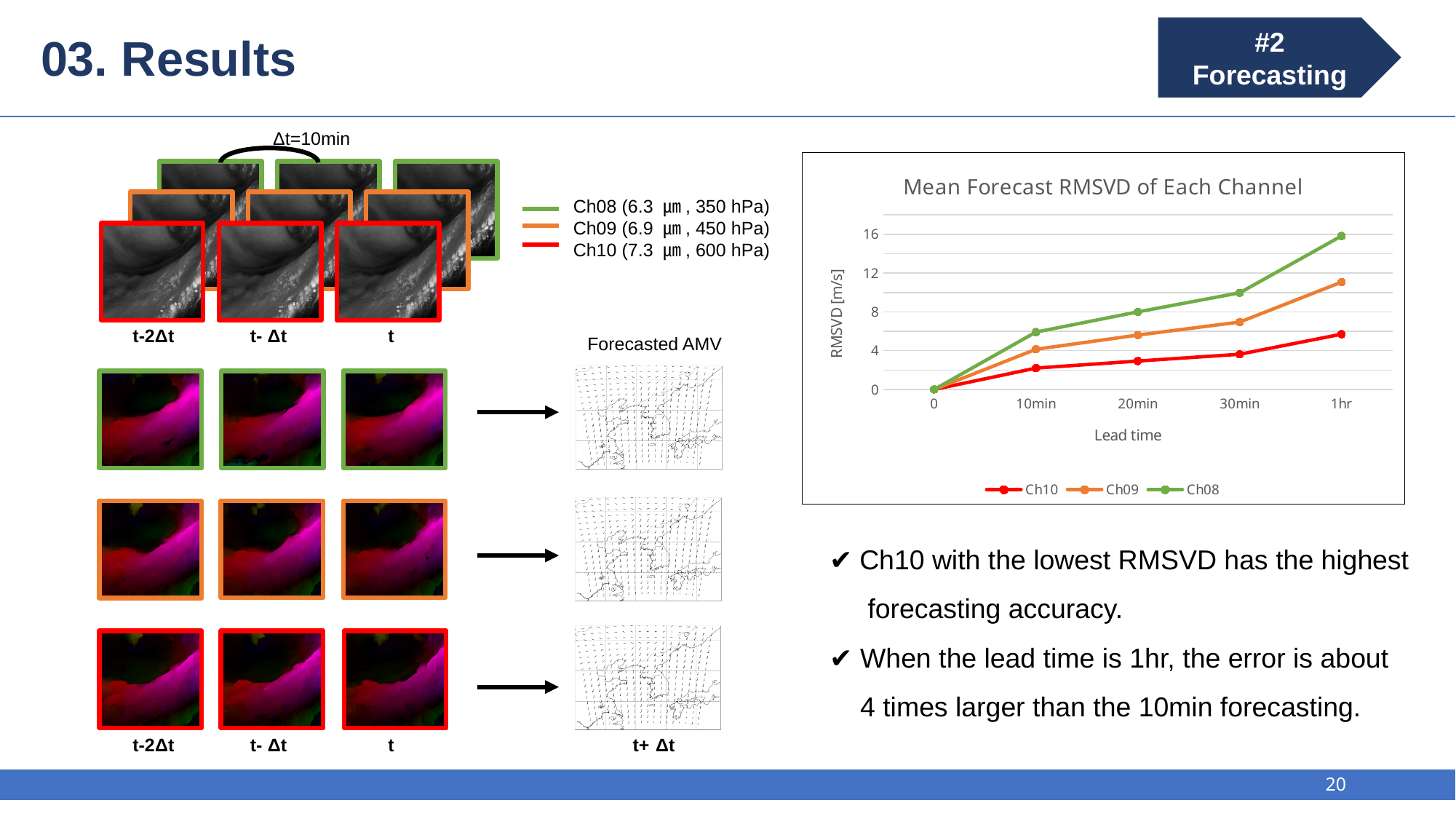
In the "Mean Forecast RMSVD of Each Channel" chart, which channel has the highest RMSVD at a lead time of 1hr? Ch08 What is the label of the y axis in the "Mean Forecast RMSVD of Each Channel" chart? RMSVD [m/s] How many lead-time points are plotted along the x axis of the "Mean Forecast RMSVD of Each Channel" chart? 5 In the "Mean Forecast RMSVD of Each Channel" chart, is the RMSVD of Ch10 at 1hr greater or less than 8? less What kind of chart is "Mean Forecast RMSVD of Each Channel"? line chart In the "Mean Forecast RMSVD of Each Channel" chart, is the RMSVD of Ch08 at 1hr greater or less than 12? greater In the "Mean Forecast RMSVD of Each Channel" chart, is the RMSVD of Ch09 at 10min greater or less than 8? less How many series does the legend of the "Mean Forecast RMSVD of Each Channel" chart list? 3 In the "Mean Forecast RMSVD of Each Channel" chart, which is larger at 20min: the RMSVD of Ch09 or of Ch10? Ch09 In the "Mean Forecast RMSVD of Each Channel" chart, what is the RMSVD of Ch10 at a lead time of 0? 0 In the "Mean Forecast RMSVD of Each Channel" chart, does the RMSVD of Ch08 rise or fall as lead time increases? rise In the "Mean Forecast RMSVD of Each Channel" chart, which channel has the lowest RMSVD at a lead time of 30min? Ch10